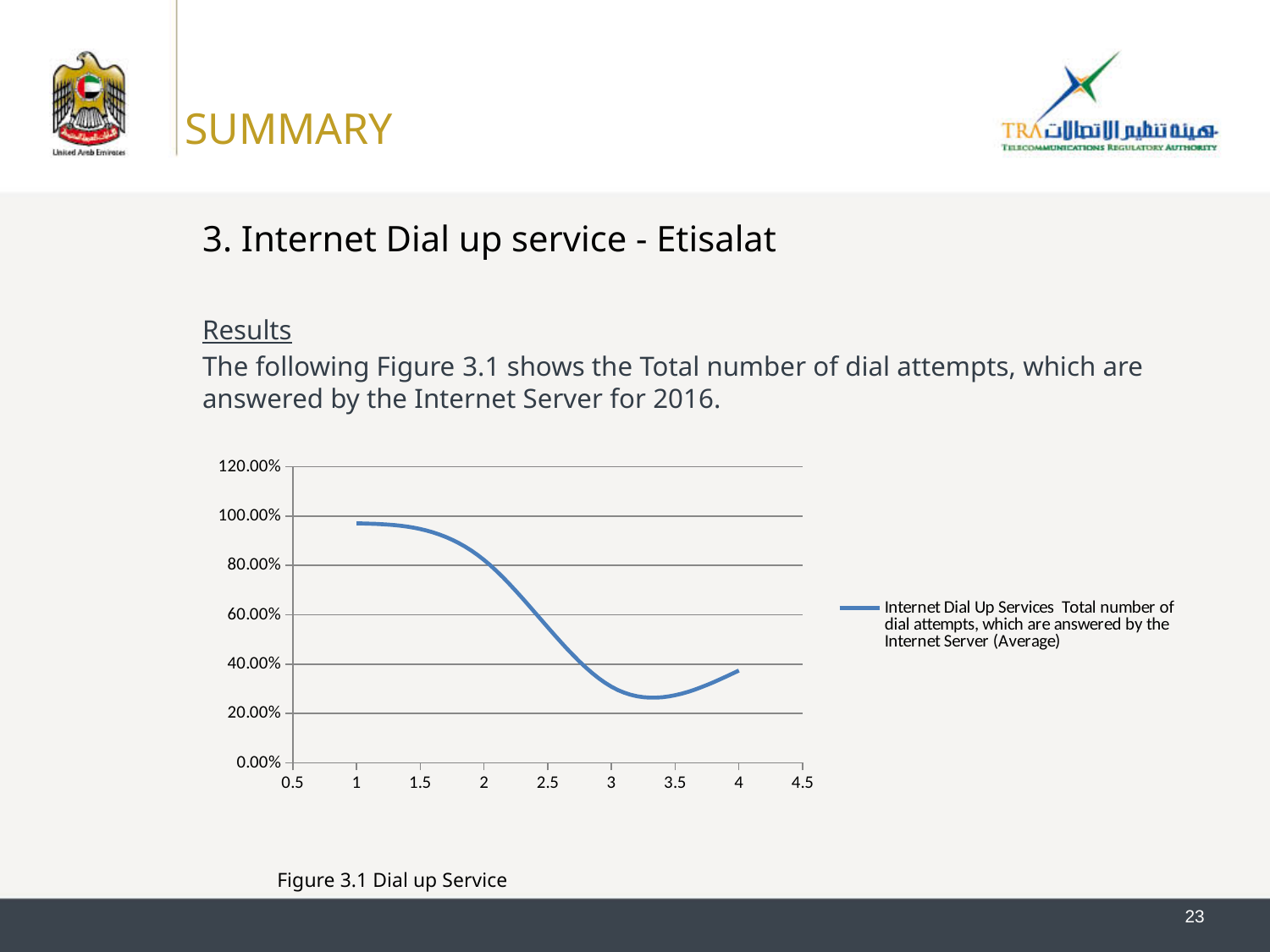
Is the value of the line at x = 3 greater or less than 40.00%? less At which x value does the line reach its highest point? 1 Is the value of the line at x = 2 greater or less than 60.00%? greater What is the highest value shown on the vertical axis of the chart? 120.00% What is the legend entry for the line in the chart? Internet Dial Up Services Total number of dial attempts, which are answered by the Internet Server (Average) Which is larger, the value of the line at x = 1 or at x = 3? x = 1 What kind of chart is shown in Figure 3.1? line chart Is the value of the line at x = 1 greater or less than 80.00%? greater How many series does the legend of the chart list? 1 Does the line rise or fall between x = 1 and x = 3? fall What is the caption given below the chart? Figure 3.1 Dial up Service